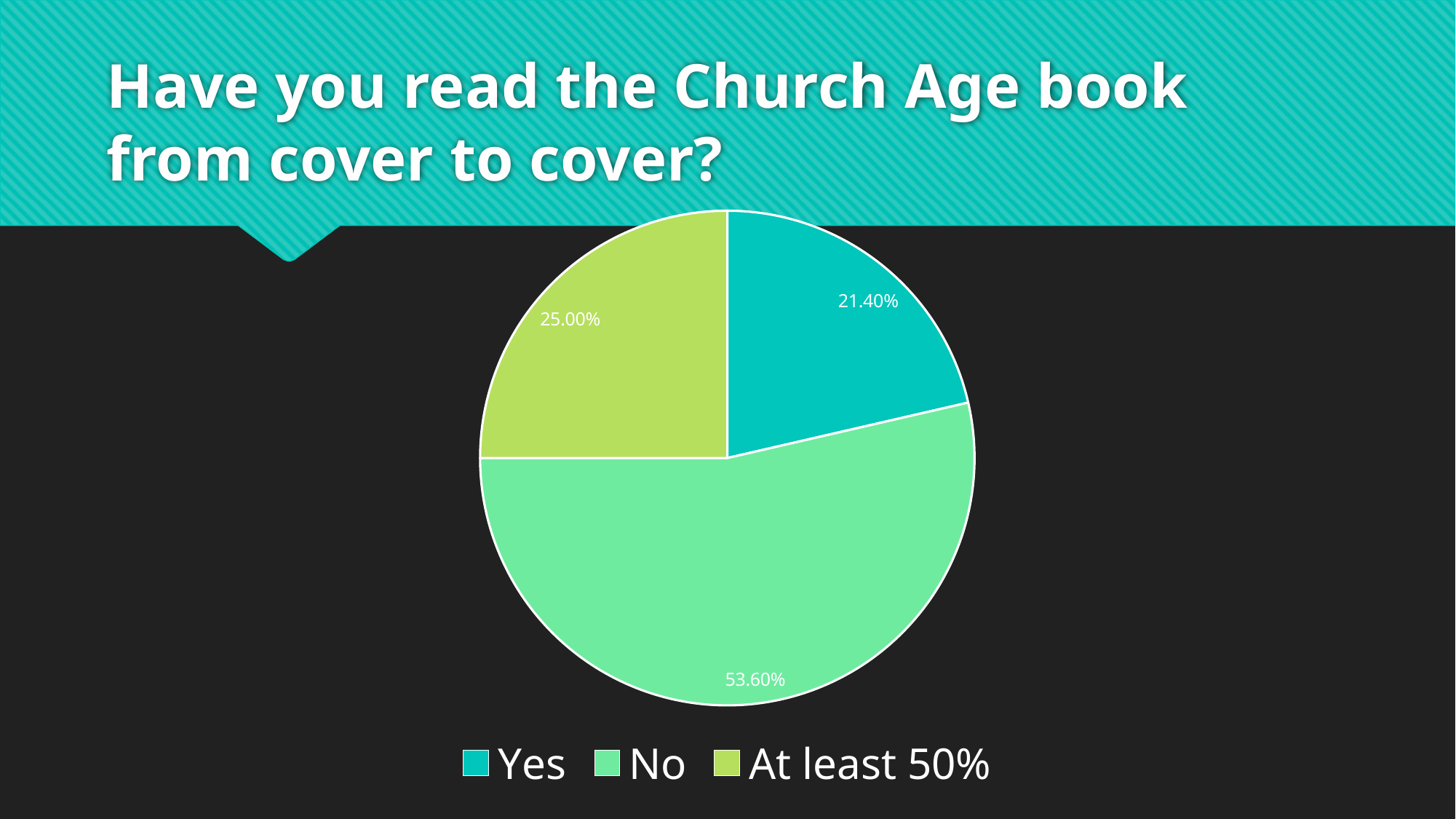
What percentage of respondents answered "No"? 53.60% Which response has the smallest share of the pie? Yes What percentage of respondents answered "At least 50%"? 25.00% What is the title of the slide containing the chart? Have you read the Church Age book from cover to cover? What is the difference in percentage points between the "No" and "Yes" slices? 32.20% What percentage of respondents answered "Yes"? 21.40% Which response has the largest share of the pie? No Which slice is larger, "Yes" or "At least 50%"? At least 50% What kind of chart is shown on the slide? Pie chart How many entries does the legend list? 3 What is the difference in percentage points between the "At least 50%" and "Yes" slices? 3.60% How many slices does the pie chart have? 3